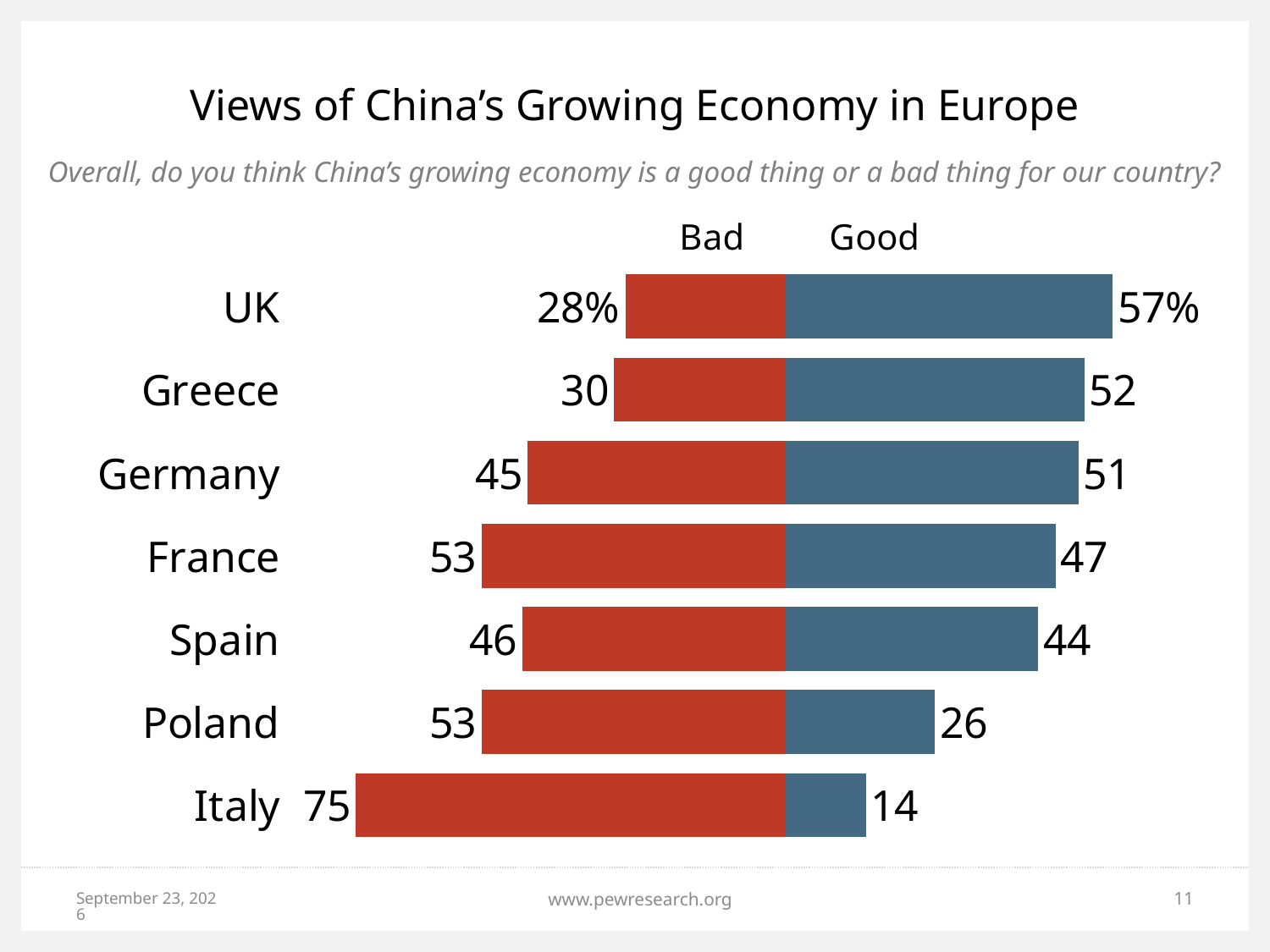
What percentage of respondents in the UK say China's growing economy is a good thing? 57% What is the 'Bad' value for Germany? 45 Which is larger for Spain, the 'Bad' value or the 'Good' value? Bad What is the 'Good' value for Poland? 26 Which country has the highest 'Bad' value? Italy What type of chart is shown on the slide? Bar chart Which country has the lowest 'Good' value? Italy How many countries are shown in the chart? 7 What colour represents the 'Bad' responses in the chart? Red How many series does the chart show? 2 What is the difference between the 'Bad' and 'Good' values for Italy? 61 Which country has the lowest 'Bad' value? UK